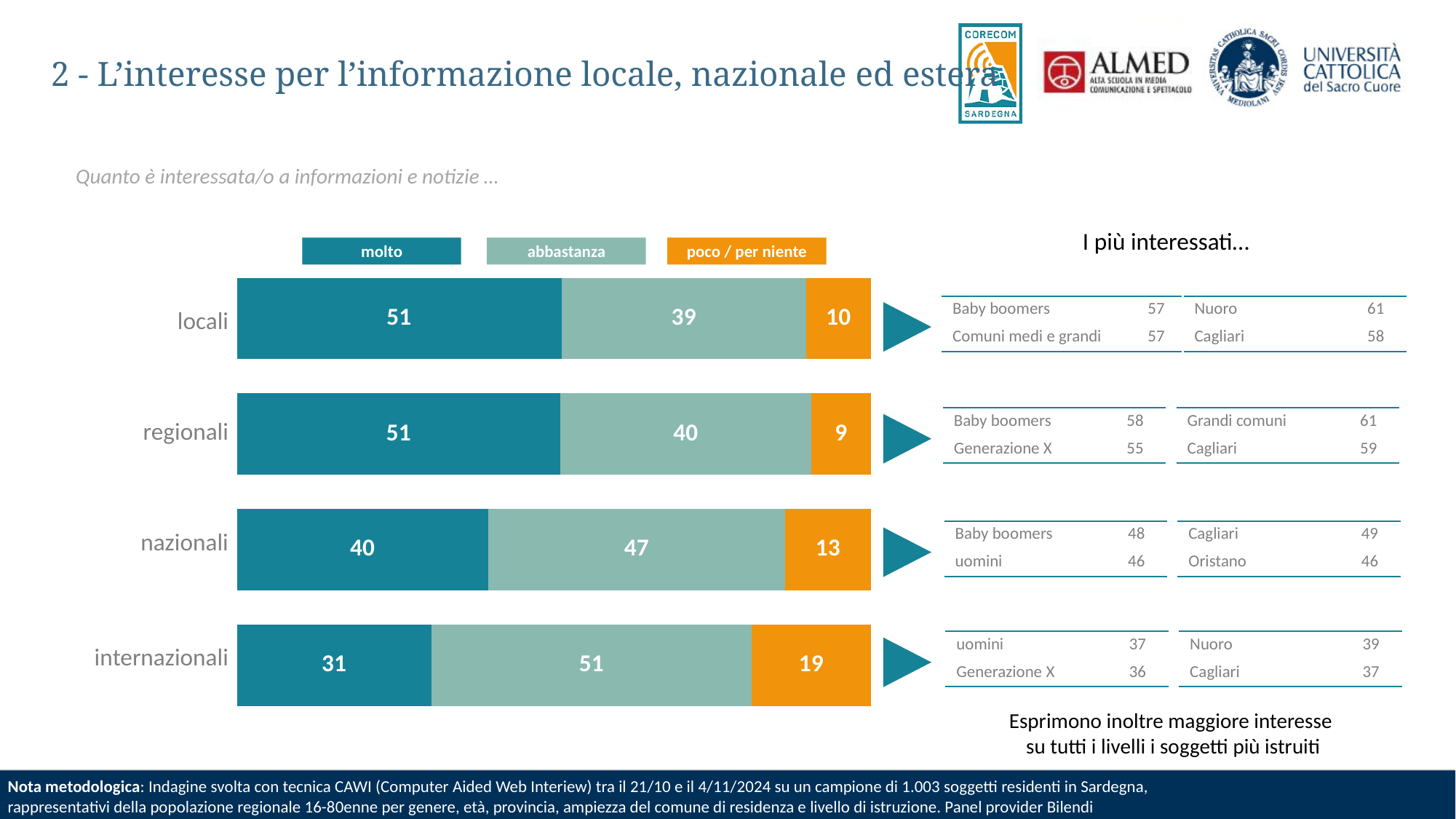
What is the difference between the "molto" values for "locali" and "internazionali"? 20 How many categories are shown on the bar chart? 4 Which category has the lowest "molto" value? internazionali How many series does the legend list? 3 Is the "abbastanza" value larger for "regionali" or for "internazionali"? internazionali What is the value of "poco / per niente" for "internazionali"? 19 What is the value of "molto" for "locali"? 51 What is the total of the stacked bar for "regionali"? 100 Which category has the highest "poco / per niente" value? internazionali What kind of chart is shown on the slide? stacked bar chart What is the value of "abbastanza" for "nazionali"? 47 Which colour represents the "poco / per niente" series in the legend? orange